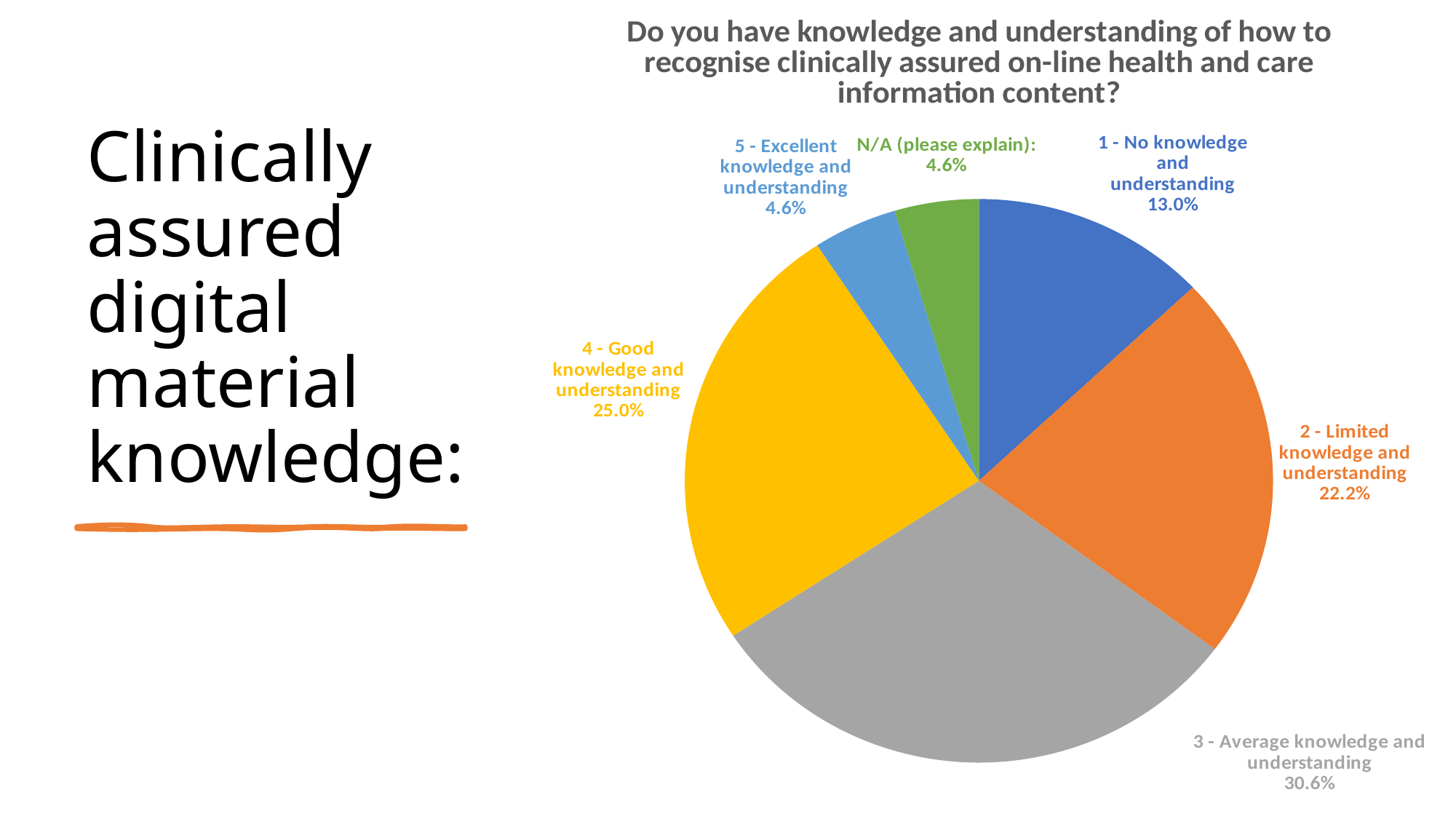
How many slices does the pie chart have? 6 What is the difference in percentage points between '3 - Average knowledge and understanding' and '2 - Limited knowledge and understanding'? 8.4 What is the difference in percentage points between '1 - No knowledge and understanding' and '5 - Excellent knowledge and understanding'? 8.4 Which is larger: the share for '4 - Good knowledge and understanding' or the share for '2 - Limited knowledge and understanding'? 4 - Good knowledge and understanding What kind of chart is shown on the slide? Pie chart What percentage of respondents answered '3 - Average knowledge and understanding'? 30.6% What is the title of the pie chart? Do you have knowledge and understanding of how to recognise clinically assured on-line health and care information content? What percentage of respondents answered '4 - Good knowledge and understanding'? 25.0% What percentage of respondents answered 'N/A (please explain)'? 4.6% Which response category has the largest share of the pie? 3 - Average knowledge and understanding What colour is the slice for '3 - Average knowledge and understanding'? Grey What percentage of respondents answered '1 - No knowledge and understanding'? 13.0%